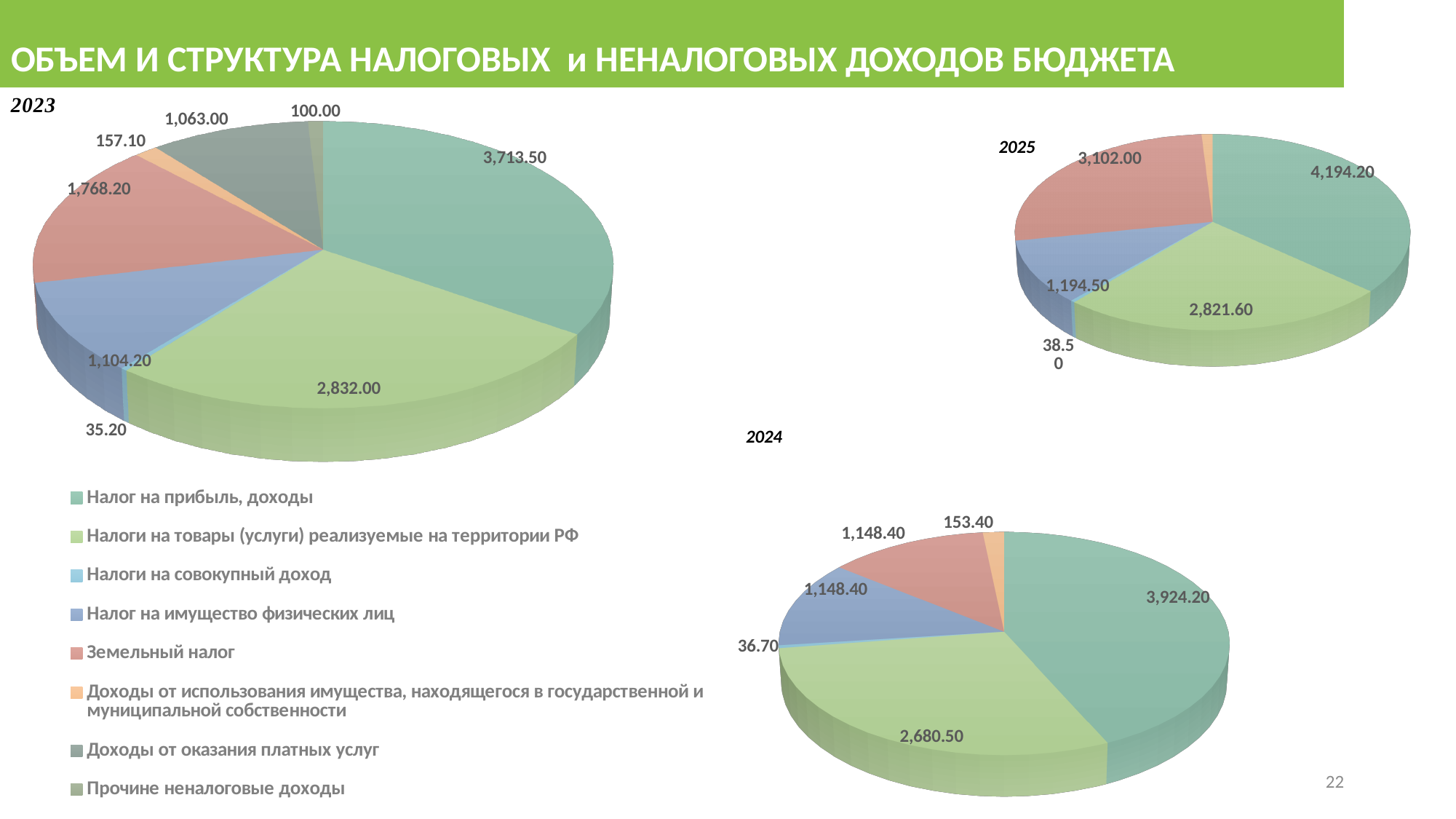
In the 2025 pie chart, what is the difference between Налог на прибыль, доходы and Земельный налог? 1,092.20 In the 2023 pie chart, which category has the smallest value? Налоги на совокупный доход In the 2023 pie chart, which is larger: Земельный налог or Налог на имущество физических лиц? Земельный налог In the 2024 pie chart, what is the difference between Налог на прибыль, доходы and Налоги на товары (услуги) реализуемые на территории РФ? 1,243.70 In the 2024 pie chart, what is the value for Налоги на товары (услуги) реализуемые на территории РФ? 2,680.50 In the 2025 pie chart, which category has the largest value? Налог на прибыль, доходы What kind of chart is used for the 2024 data? Pie chart In the 2023 pie chart, what is the value for Налог на прибыль, доходы? 3,713.50 How many entries does the legend list? 8 In the 2023 pie chart, what is the value for Доходы от оказания платных услуг? 1,063.00 In the 2025 pie chart, what is the value for Земельный налог? 3,102.00 How many pie charts are shown on the slide? 3